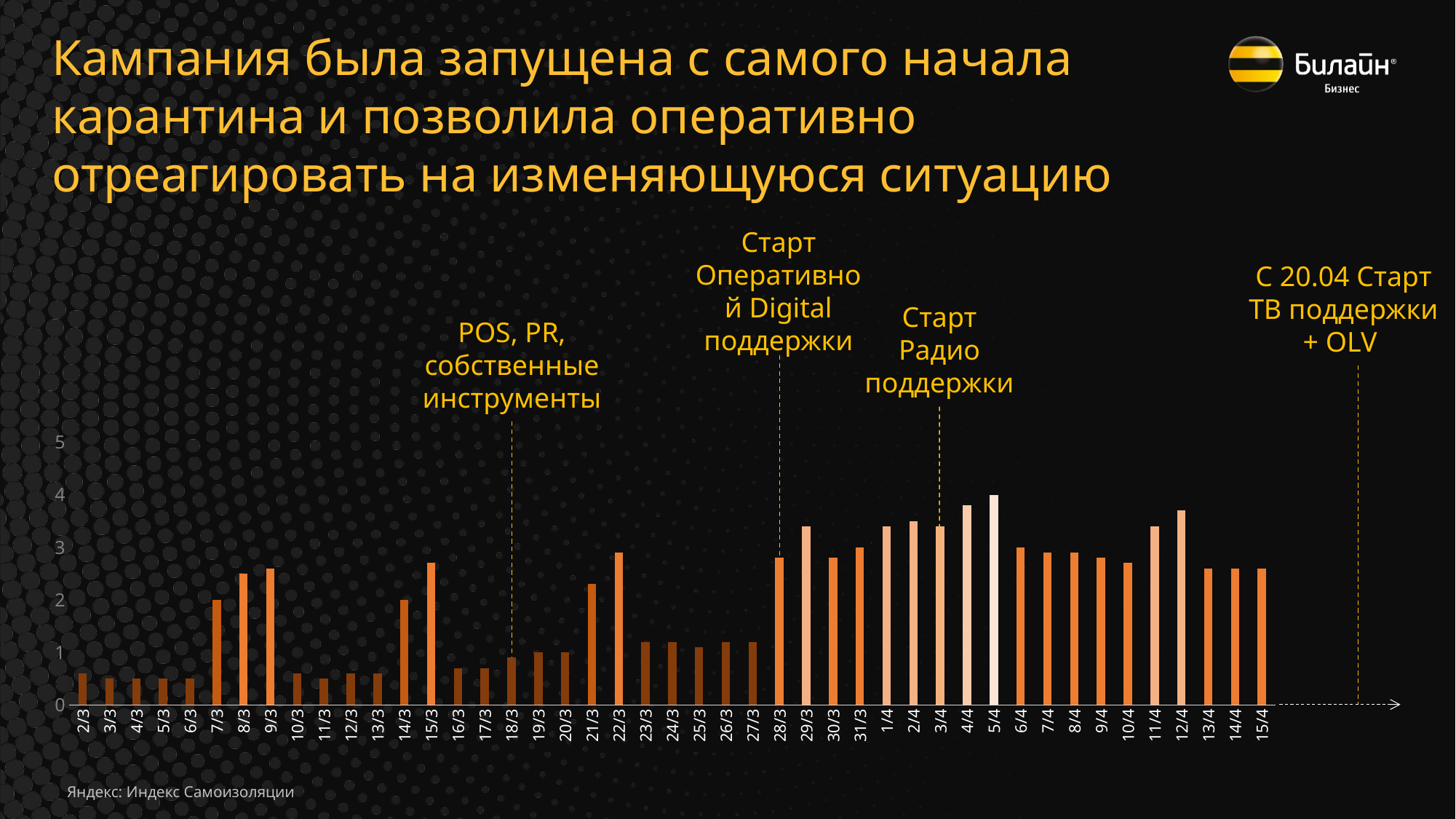
How many dates (bars) are plotted on the x axis of the chart? 45 Is the value for 5/4 greater or less than 3? greater Which date has the highest bar in the chart? 5/4 Which is larger, the value for 29/3 or the value for 30/3? 29/3 What data source is cited below the chart? Яндекс: Индекс Самоизоляции Do the values generally rise or fall from 2/3 to 5/4? rise What kind of chart is shown on the slide? bar chart Is the value for 7/3 greater or less than 1? greater Is the value for 10/3 greater or less than 1? less Which is larger, the value for 12/4 or the value for 13/4? 12/4